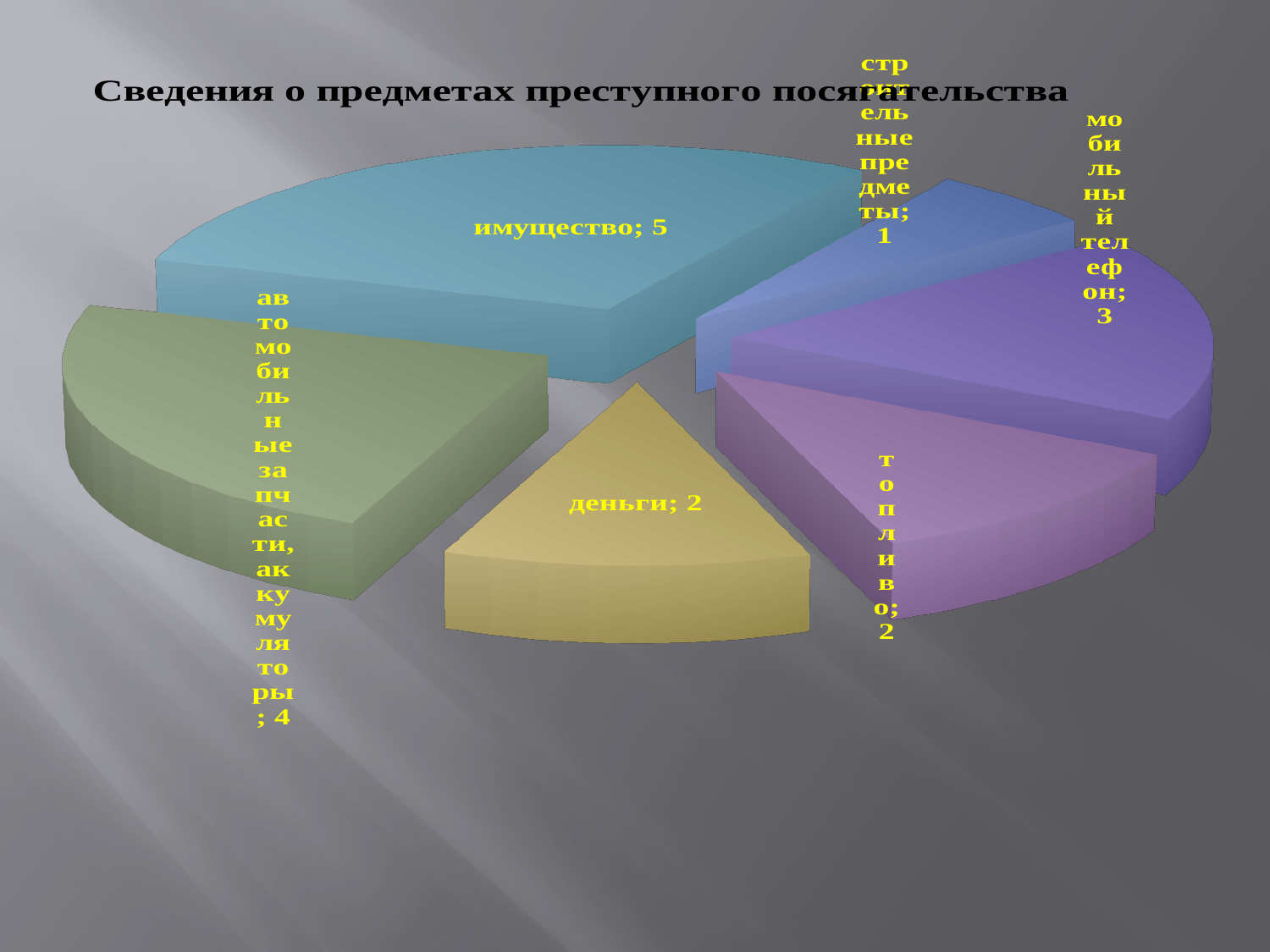
What is the value for деньги? 2 Which category has the highest value? имущество What is the value for топливо? 2 What is the title of the chart? Сведения о предметах преступного посягательства How many slices does the pie chart have? 6 What is the value for автомобильные запчасти, аккумуляторы? 4 What kind of chart is shown on the slide? pie chart Which is larger, the value for мобильный телефон or the value for топливо? мобильный телефон What is the difference between the values for имущество and деньги? 3 What is the value for имущество? 5 Which category has the lowest value? строительные предметы What is the value for мобильный телефон? 3